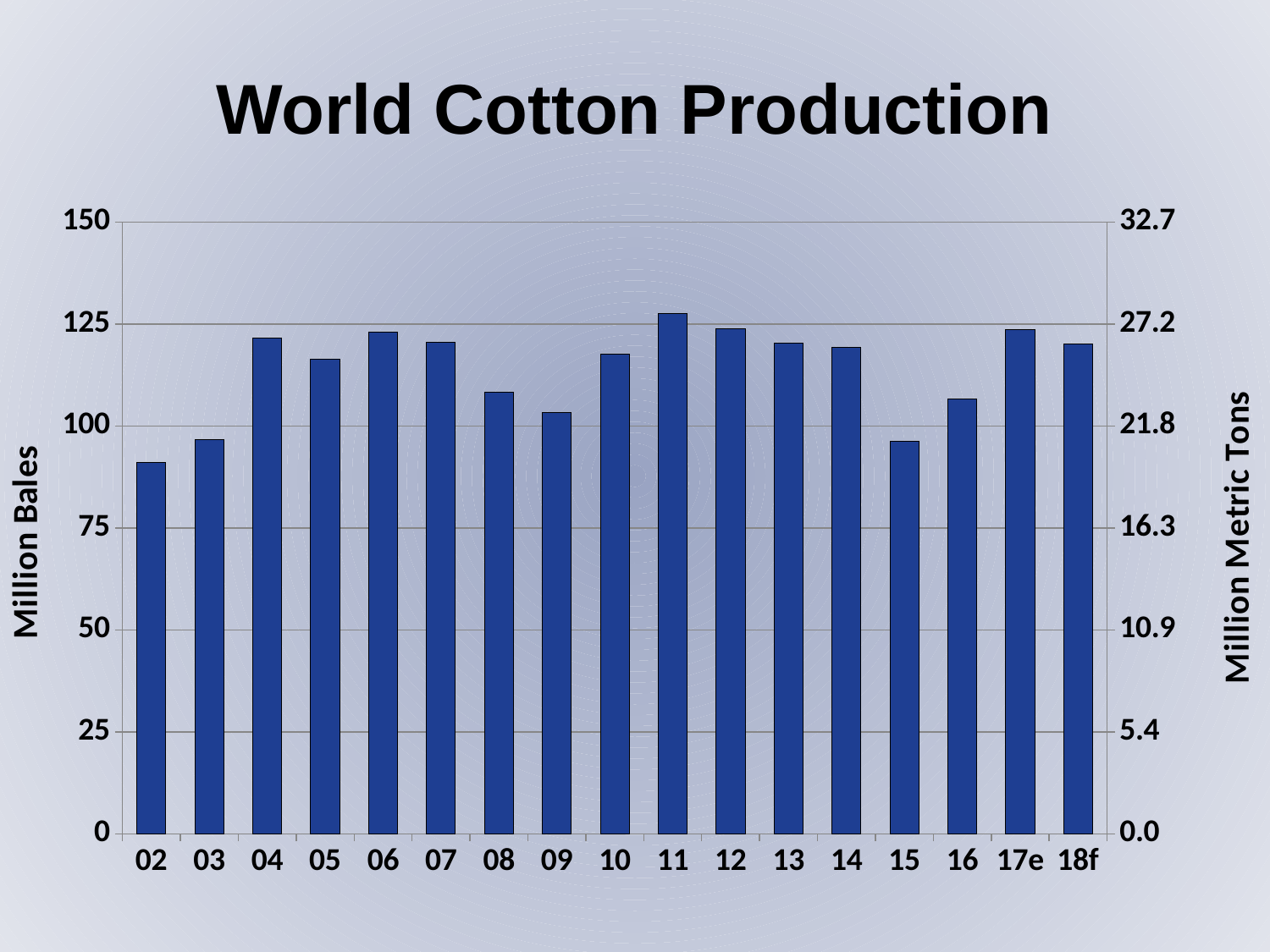
Which year has the highest world cotton production? 11 Which year has the lowest world cotton production? 02 Is the value for 11 greater or less than 125 million bales? greater What kind of chart is shown on the slide? Bar chart What is the title of the left vertical axis? Million Bales Which is larger, the value for 04 or the value for 02? 04 Is the value for 02 greater or less than 100 million bales? less Is the value for 08 greater or less than 100 million bales? greater Do the values rise or fall from 11 to 15? fall How many bars (years) are plotted in the World Cotton Production chart? 17 Which is larger, the value for 09 or the value for 10? 10